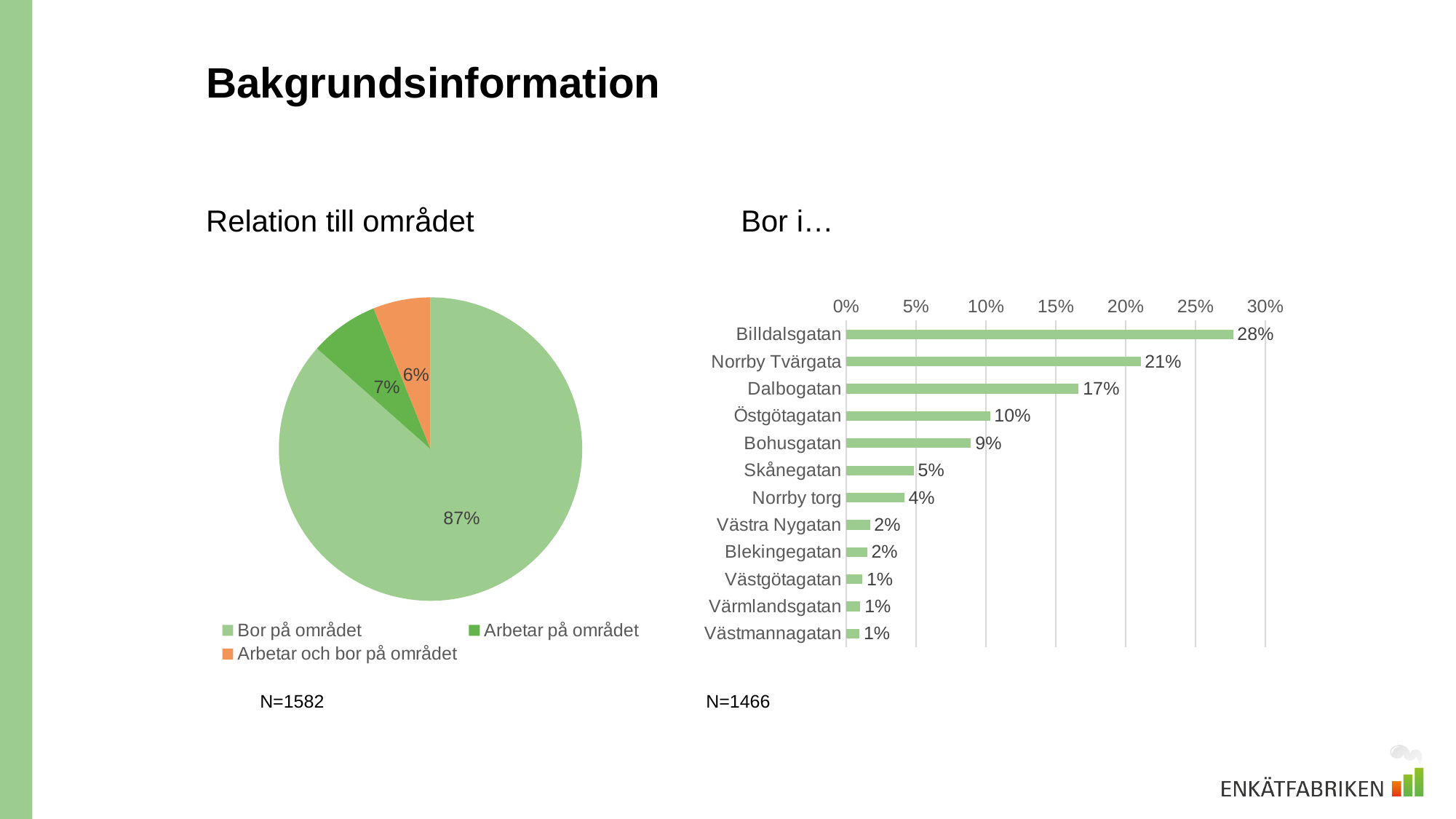
In the 'Bor i…' chart, what is the difference between Billdalsgatan and Norrby Tvärgata? 7% In the 'Bor i…' chart, how many categories are shown? 12 What kind of chart is the 'Bor i…' chart? Bar chart In the 'Bor i…' chart, what is the value for Norrby torg? 4% What kind of chart is the 'Relation till området' chart? Pie chart In the 'Relation till området' pie chart, what share is 'Arbetar och bor på området'? 6% In the 'Bor i…' chart, which category has the highest value? Billdalsgatan In the 'Bor i…' chart, which is larger, Östgötagatan or Bohusgatan? Östgötagatan In the 'Bor i…' chart, what is the value for Dalbogatan? 17% In the 'Relation till området' pie chart, what share is 'Arbetar på området'? 7% In the 'Relation till området' pie chart, what share is 'Bor på området'? 87% In the 'Relation till området' pie chart, how many slices are there? 3